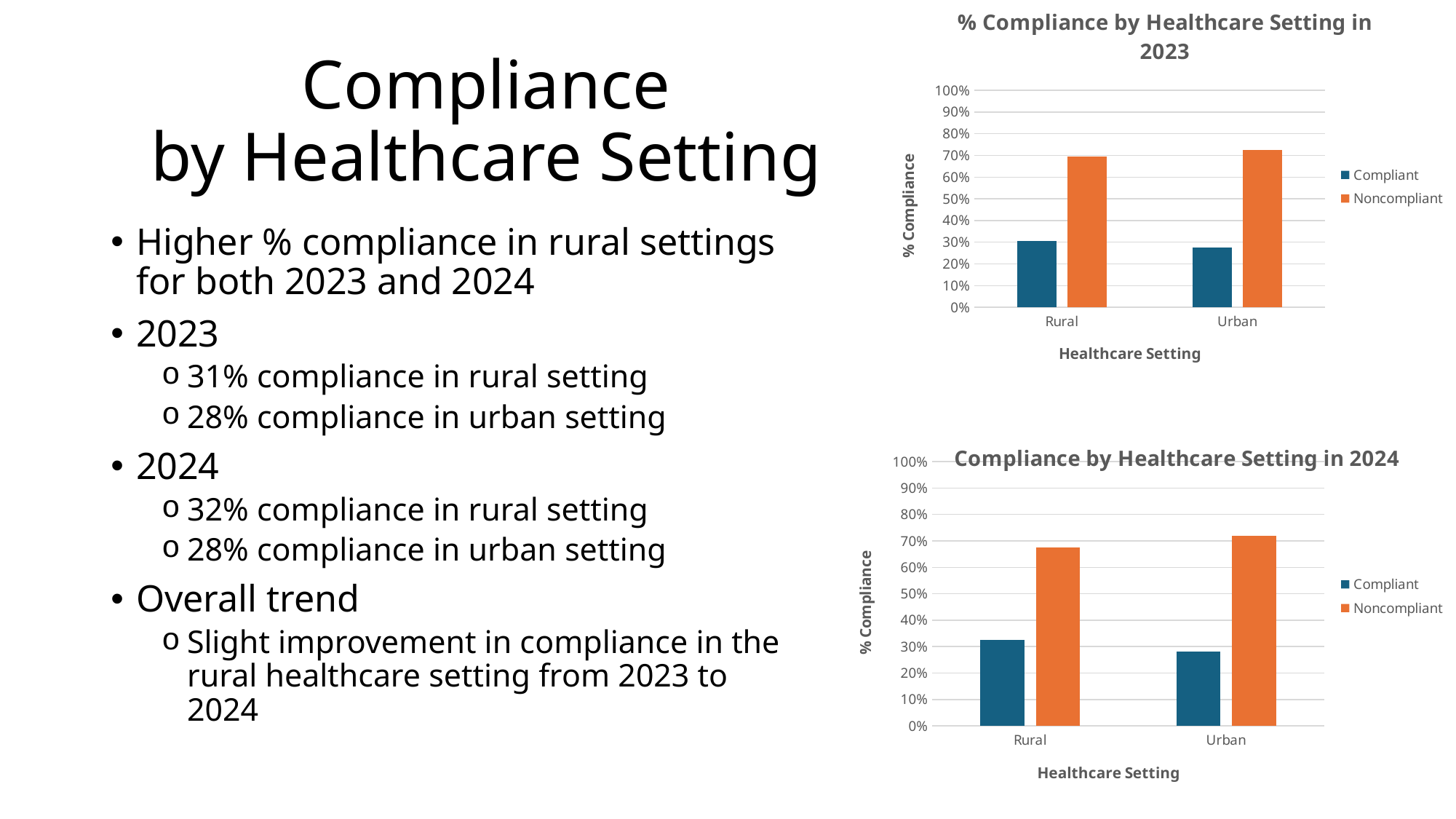
In the '% Compliance by Healthcare Setting in 2023' chart, is the Compliant value for Urban greater or less than 40%? less In the 'Compliance by Healthcare Setting in 2024' chart, is the Noncompliant value for Urban greater or less than 60%? greater What kind of chart is the '% Compliance by Healthcare Setting in 2023' chart? bar chart How many healthcare setting categories are shown on the x axis of the '% Compliance by Healthcare Setting in 2023' chart? 2 In the 'Compliance by Healthcare Setting in 2024' chart, which healthcare setting has the lower Noncompliant bar? Rural What are the two legend entries in the 'Compliance by Healthcare Setting in 2024' chart? Compliant and Noncompliant How many series does the legend of the 'Compliance by Healthcare Setting in 2024' chart list? 2 What is the y-axis title of the '% Compliance by Healthcare Setting in 2023' chart? % Compliance In the '% Compliance by Healthcare Setting in 2023' chart, is the Noncompliant value for Rural greater or less than 60%? greater In the '% Compliance by Healthcare Setting in 2023' chart, which is larger for Rural: the Compliant bar or the Noncompliant bar? Noncompliant In the 'Compliance by Healthcare Setting in 2024' chart, which healthcare setting has the higher Compliant bar? Rural